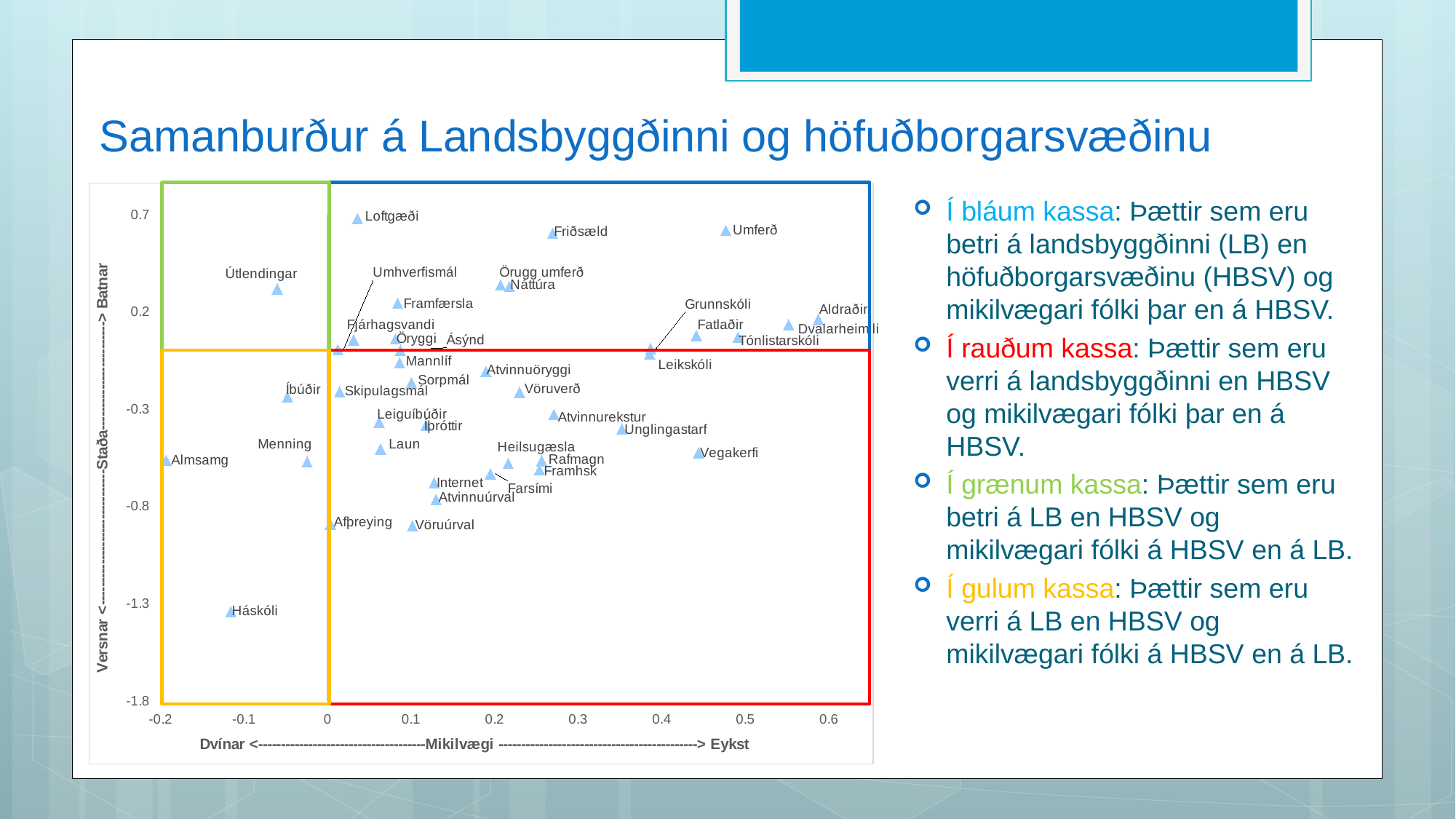
Is the horizontal-axis value for Almsamg greater or less than -0.1? less What kind of chart is shown on the slide? scatter chart Which point has the larger horizontal-axis value, Vegakerfi or Laun? Vegakerfi Which labelled point is furthest to the left on the horizontal (Mikilvægi) axis? Almsamg Is the horizontal-axis value for Umferð greater or less than 0.4? greater What is the title of the horizontal axis of the chart? Dvínar <--- Mikilvægi ---> Eykst How many coloured boxes are drawn over the chart area? 4 Which labelled point has the highest value on the vertical (Staða) axis? Loftgæði Is the vertical-axis value for Háskóli greater or less than -0.8? less Which labelled point is furthest to the right on the horizontal (Mikilvægi) axis? Aldraðir Which point has the higher vertical-axis value, Friðsæld or Vöruverð? Friðsæld Which labelled point has the lowest value on the vertical (Staða) axis? Háskóli